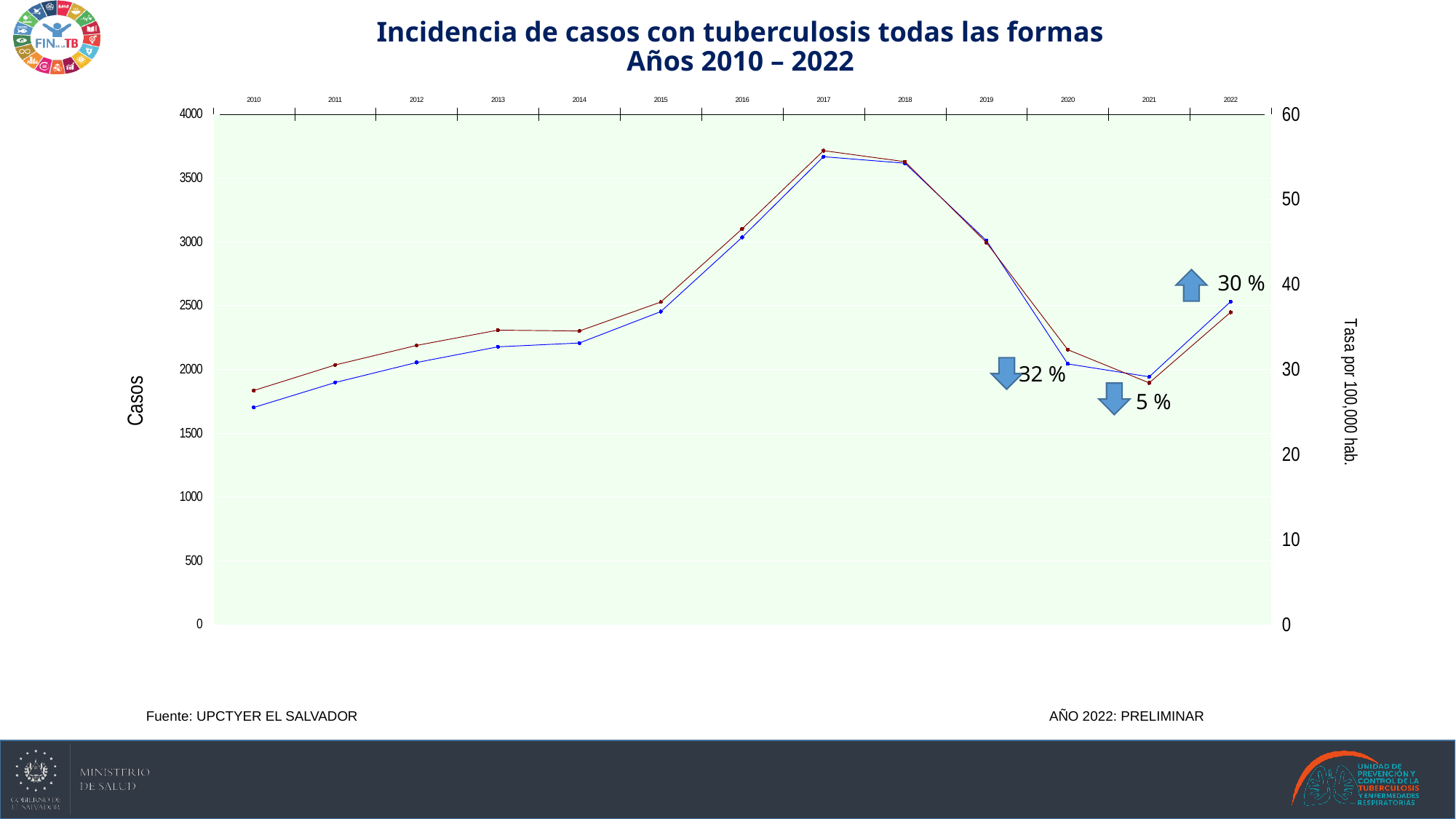
What percentage change is annotated between 2019 and 2020? 32 % Is the value of the blue line in 2017 greater or less than 3500 on the left axis? greater Is the value of the blue line in 2010 greater or less than 2000 on the left axis? less How many years are plotted along the x axis? 13 Is the value of the blue line in 2020 greater or less than 2500 on the left axis? less Do the values rise or fall from 2010 to 2017? rise What kind of chart is shown on the slide? line chart What is the label of the right-hand vertical axis? Tasa por 100,000 hab. Do the values rise or fall from 2018 to 2021? fall In which year is the blue line at its lowest point? 2010 In which year do the lines reach their highest point? 2017